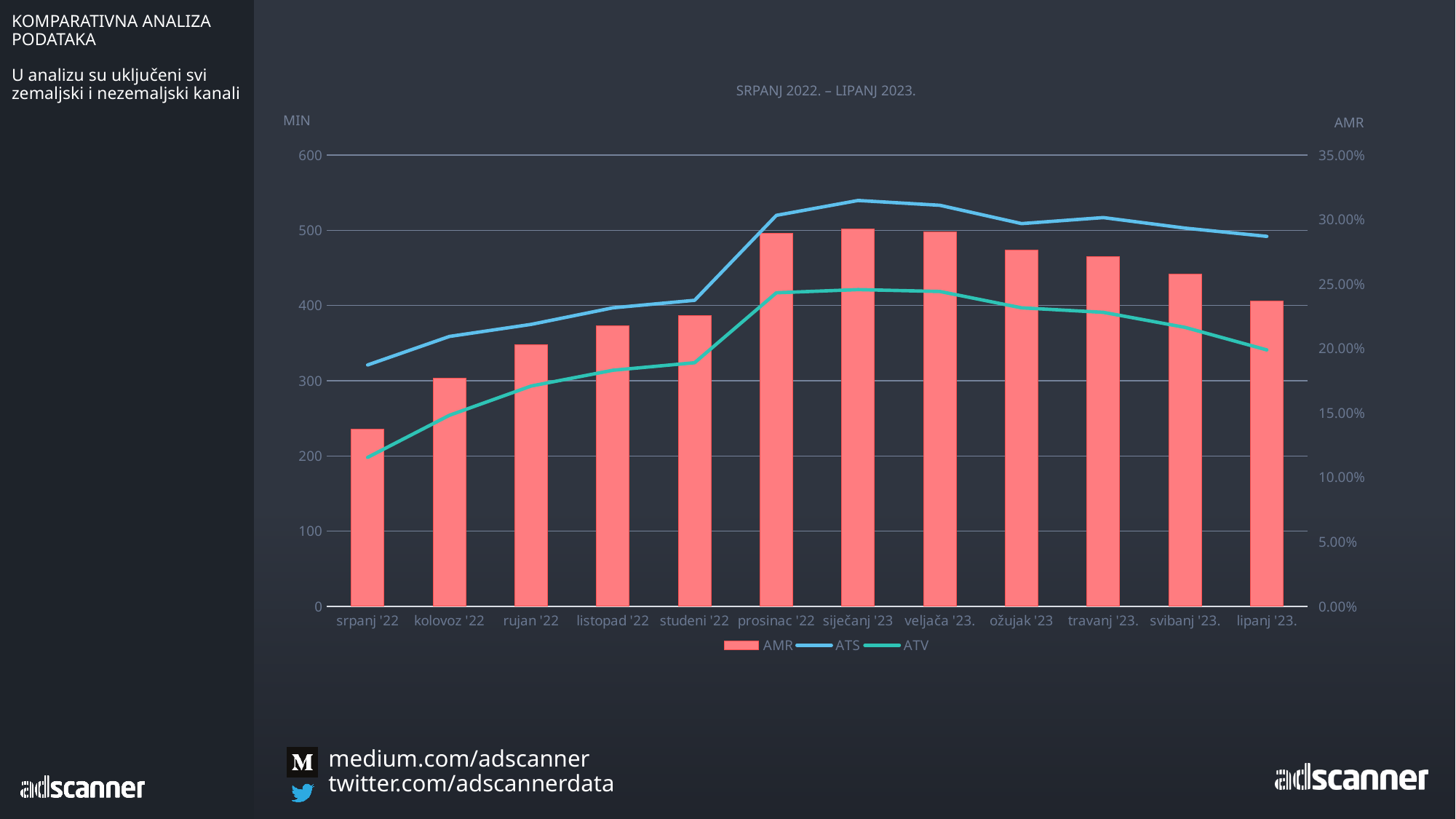
Which series is plotted as bars in the chart? AMR Is the AMR value for siječanj '23 greater or less than 25.00%? greater Is the ATS value for siječanj '23 greater or less than 500 minutes? greater What kind of chart is shown on the slide? Combined bar and line chart Which month has the lowest AMR bar? srpanj '22 How many months are shown on the x axis of the chart? 12 Which is larger, the AMR bar for kolovoz '22 or for rujan '22? rujan '22 How many series does the chart legend list? 3 Is the AMR value for srpanj '22 greater or less than 20.00%? less What is the title of the chart? SRPANJ 2022. – LIPANJ 2023. Which month has the lowest ATS value? srpanj '22 Does the ATV line rise or fall from srpanj '22 to siječanj '23? rises